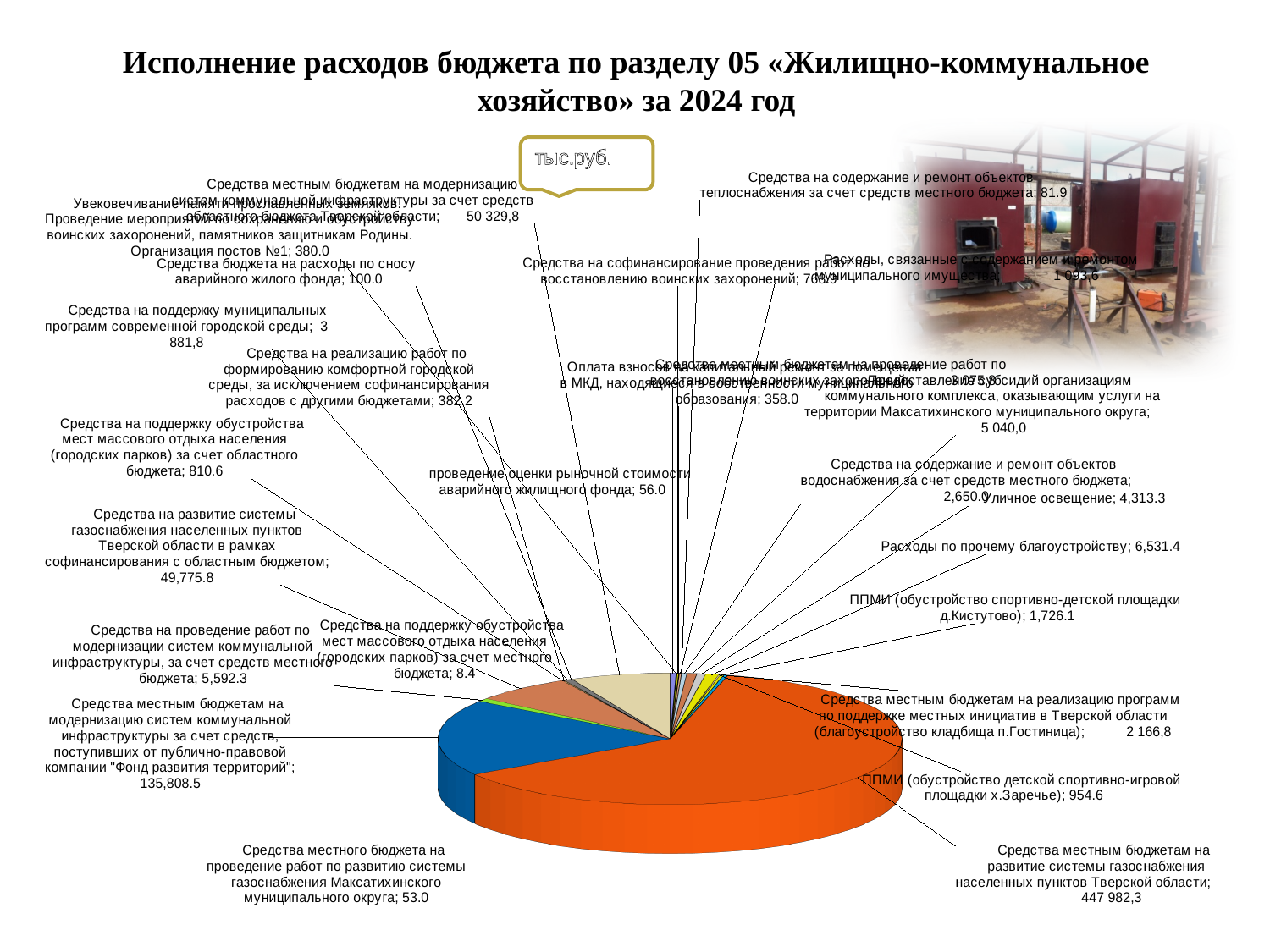
What is the value for "Уличное освещение"? 4,313.3 What kind of chart is shown on the slide? pie chart What is the value for "ППМИ (обустройство детской спортивно-игровой площадки х.Заречье)"? 954.6 What is the value for "Средства на поддержку обустройства мест массового отдыха населения (городских парков) за счет местного бюджета"? 8.4 What is the value for "Расходы по прочему благоустройству"? 6,531.4 What unit of measurement is indicated in the callout on the slide? тыс.руб. Which category has the largest slice of the pie? Средства местным бюджетам на развитие системы газоснабжения населенных пунктов Тверской области What is the value for "Средства на содержание и ремонт объектов водоснабжения за счет средств местного бюджета"? 2,650.0 What is the value for "Средства местным бюджетам на развитие системы газоснабжения населенных пунктов Тверской области"? 447 982,3 What is the difference between "Расходы по прочему благоустройству" (6,531.4) and "Уличное освещение" (4,313.3)? 2,218.1 Which is larger: "Уличное освещение" or "Расходы по прочему благоустройству"? Расходы по прочему благоустройству What is the value for "ППМИ (обустройство спортивно-детской площадки д.Кистутово)"? 1,726.1